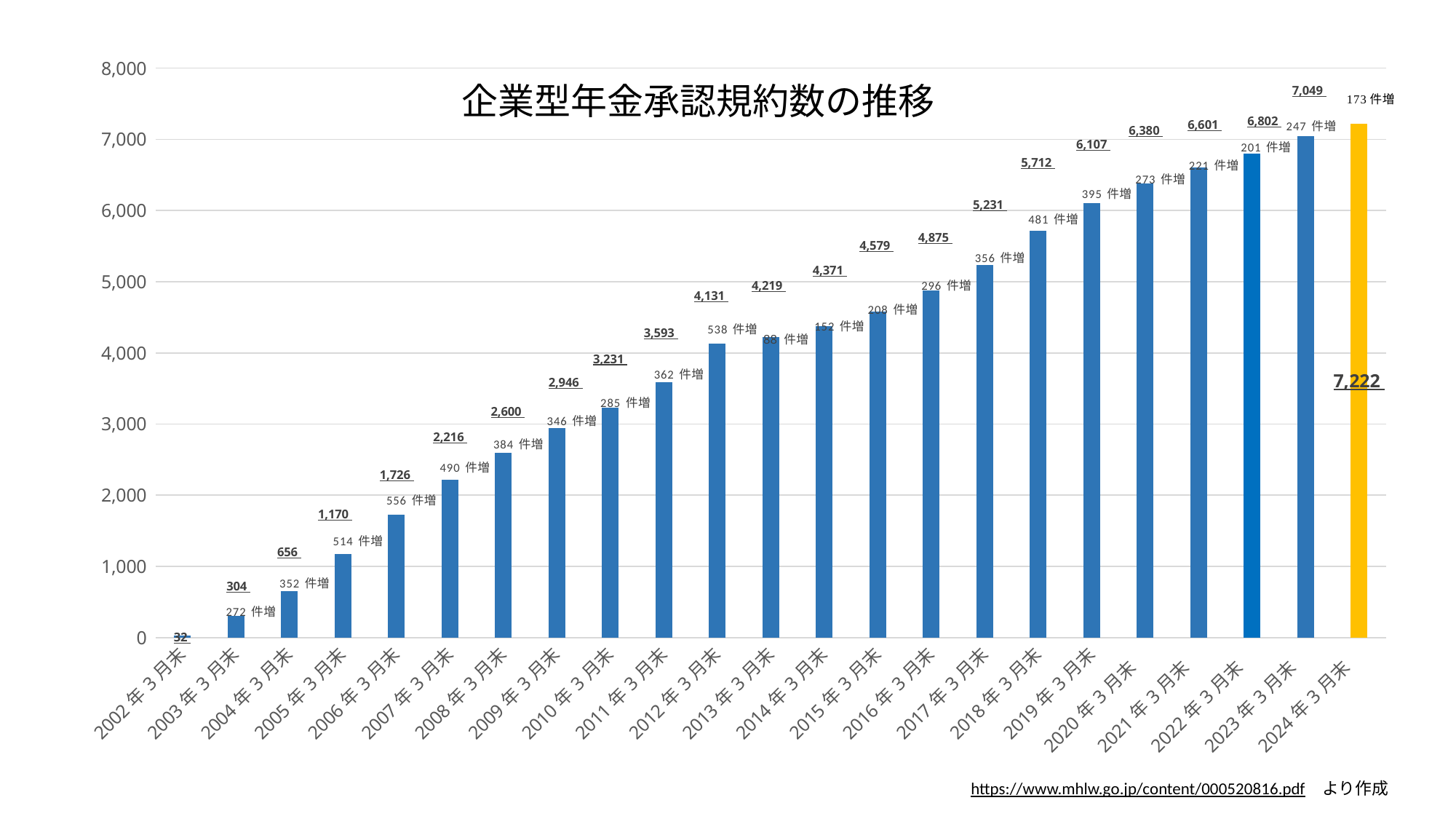
Do the values rise or fall from 2002年3月末 to 2024年3月末? rise Which is larger, the value for 2015年3月末 or the value for 2013年3月末? 2015年3月末 What is the value for 2024年3月末? 7,222 How many bars (time points) are plotted in the chart? 23 Which time point has the highest value? 2024年3月末 What is the difference between the values for 2024年3月末 and 2023年3月末? 173 Which bar is coloured differently (yellow) from the others? 2024年3月末 What kind of chart is shown on the slide? bar chart What is the value for 2007年3月末? 2,216 Which time point has the lowest value? 2002年3月末 What is the value for 2012年3月末? 4,131 What is the title of the chart? 企業型年金承認規約数の推移